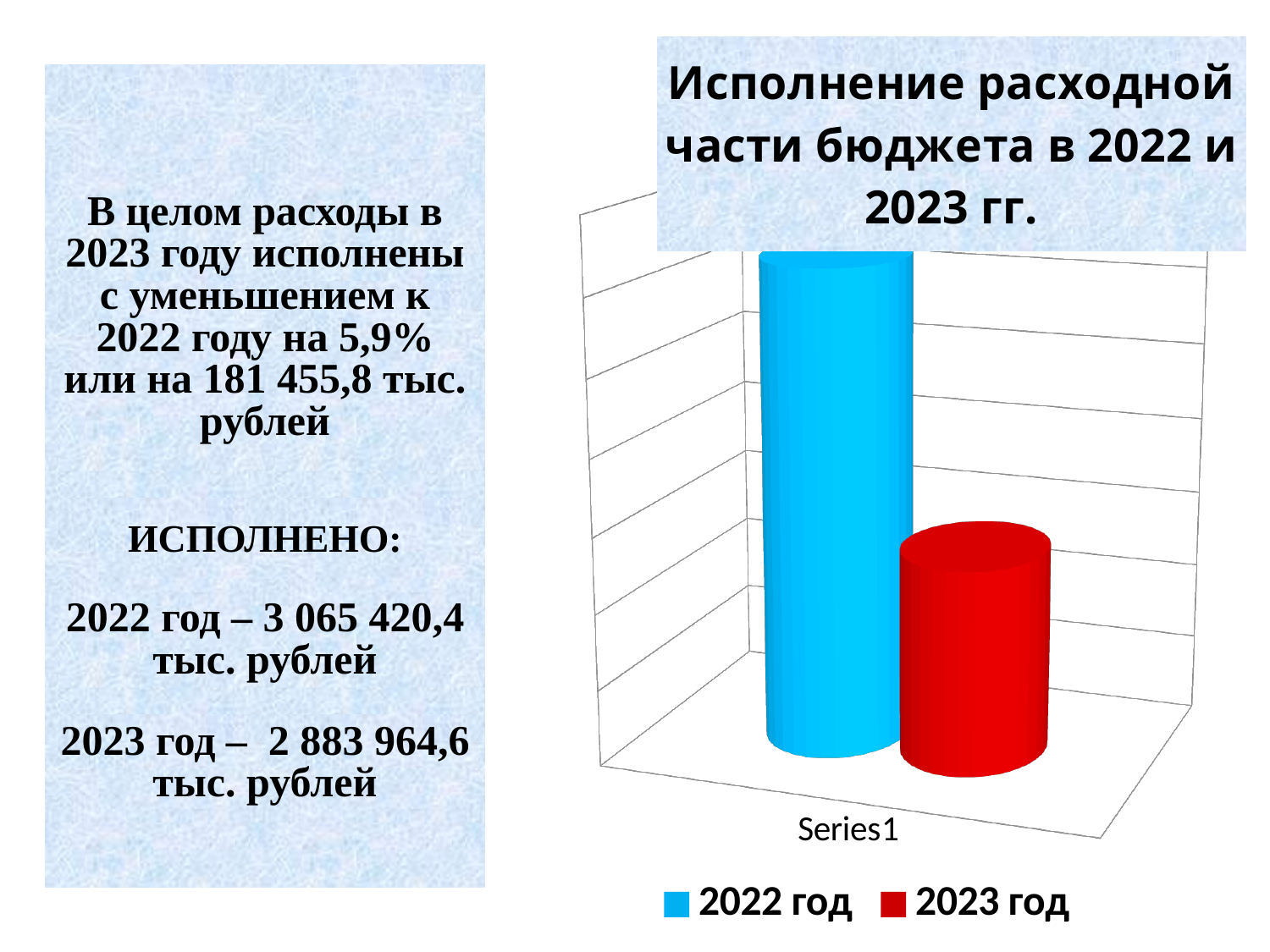
What colour is the bar for 2023 год? red Which series has the highest bar in the chart? 2022 год How many categories are shown on the chart's horizontal axis? 1 Which series has the lowest bar in the chart? 2023 год Do the bar values rise or fall from 2022 год to 2023 год? fall What kind of chart is shown on the slide? bar chart How many series does the chart legend list? 2 Which series has the taller bar, 2022 год or 2023 год? 2022 год What is the title of the chart? Исполнение расходной части бюджета в 2022 и 2023 гг.